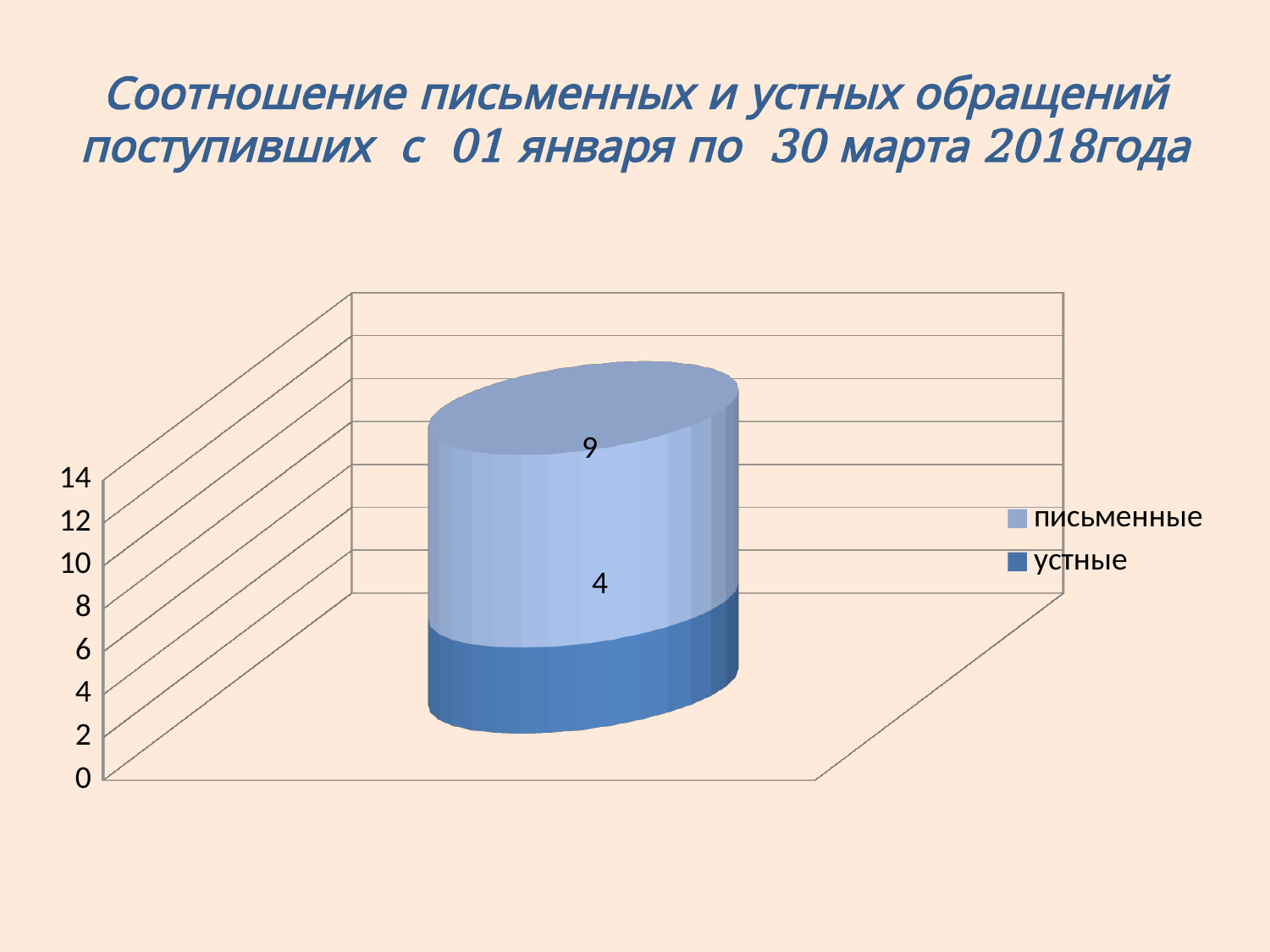
What kind of chart is shown on the slide? stacked bar chart Which series has the largest value? письменные What is the value for устные? 4 What is the difference between the values for письменные and устные? 5 Which series has the larger value, письменные or устные? письменные Which series has the smallest value? устные How many series does the legend list? 2 What is the maximum value shown on the vertical axis? 14 How many bars are plotted in the chart? 1 What is the total of the stacked bar? 13 What is the value for письменные? 9 Which legend entry is shown in the darker blue colour? устные